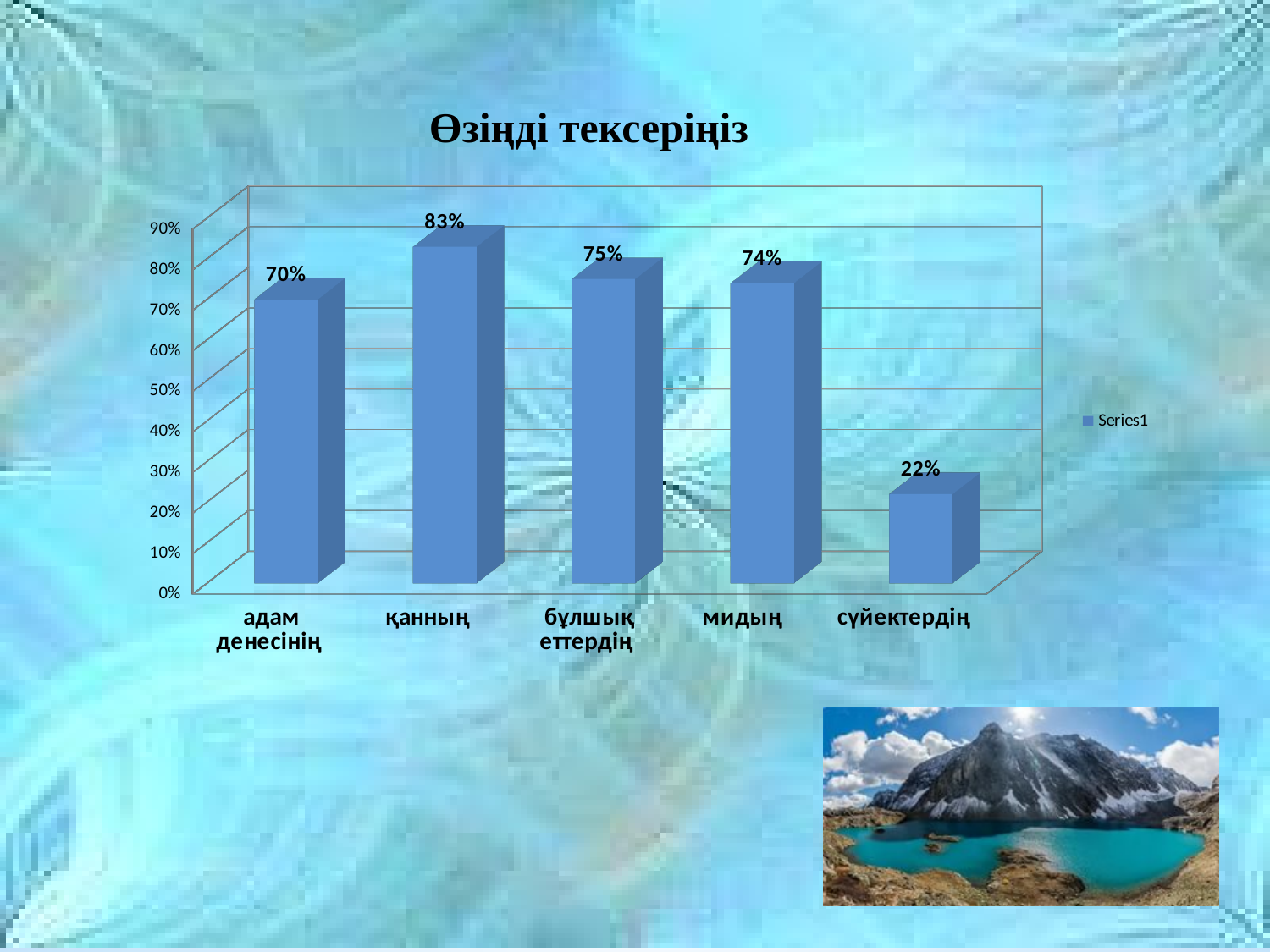
Is the value for мидың greater or less than 50%? greater How many categories are shown on the x axis? 5 What is the difference between the values for бұлшық еттердің and адам денесінің? 5% Which is larger, the value for қанның or the value for мидың? қанның What kind of chart is shown on the slide? bar chart What is the difference between the values for қанның and сүйектердің? 61% What is the value for қанның? 83% Which category has the highest value? қанның What is the value for сүйектердің? 22% What is the value for адам денесінің? 70% Which category has the lowest value? сүйектердің What is the title of the chart? Өзіңді тексеріңіз